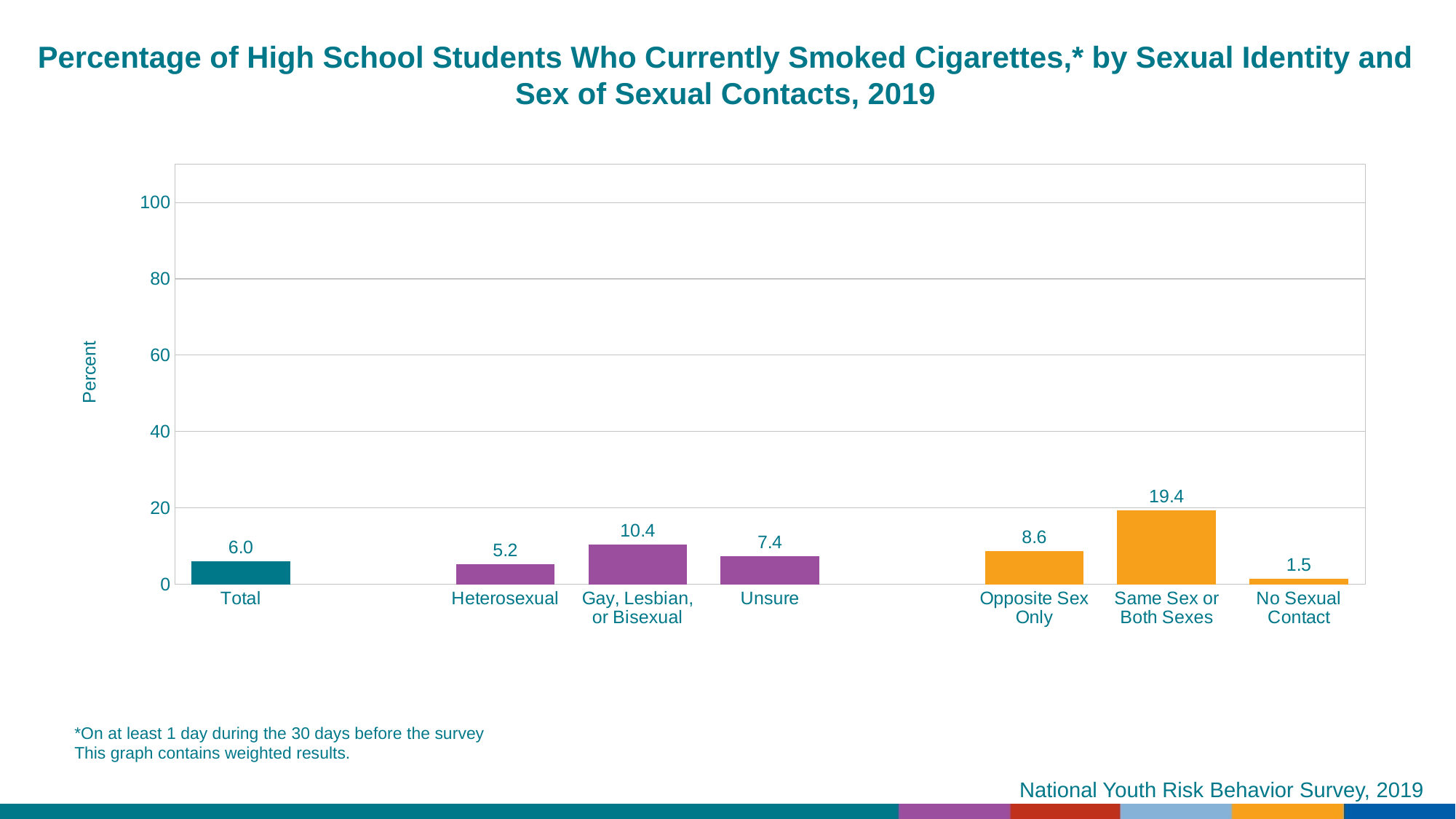
Which category has the lowest value? No Sexual Contact What is the difference between the values for Gay, Lesbian, or Bisexual and Heterosexual? 5.2 Which category has the highest value? Same Sex or Both Sexes How many categories are shown on the x axis? 7 What kind of chart is this? bar chart What is the value for Gay, Lesbian, or Bisexual? 10.4 What is the value for No Sexual Contact? 1.5 What is the value for Total? 6.0 Is the value for Same Sex or Both Sexes greater or less than 20? less Which is larger, the value for Unsure or the value for Opposite Sex Only? Opposite Sex Only What is the value for Same Sex or Both Sexes? 19.4 What is the label of the y axis? Percent